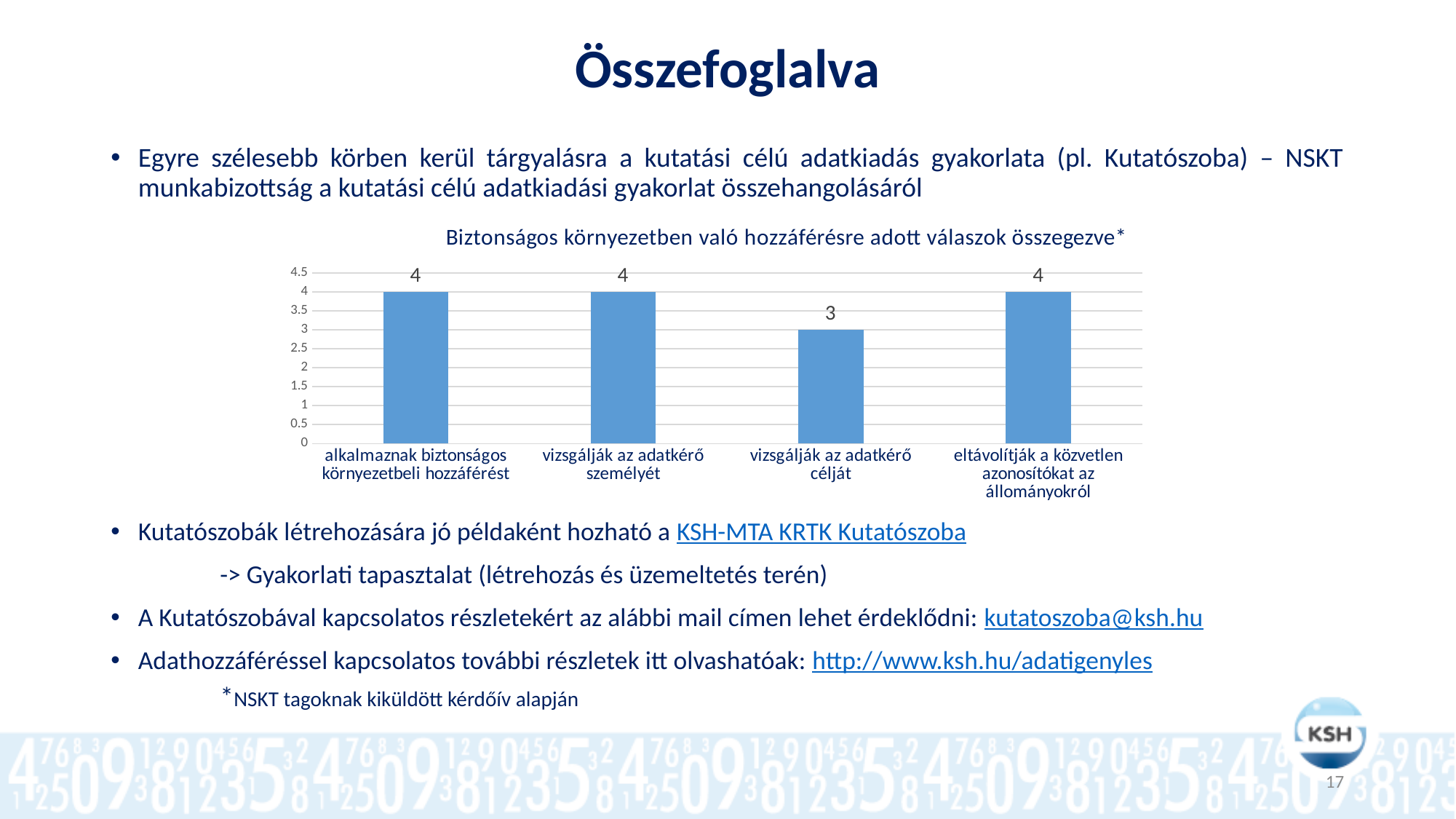
Is the value for "vizsgálják az adatkérő célját" greater or less than 3.5? less What is the value for "alkalmaznak biztonságos környezetbeli hozzáférést"? 4 What is the difference between the value for "vizsgálják az adatkérő személyét" and the value for "vizsgálják az adatkérő célját"? 1 What kind of chart is shown on the slide? bar chart What is the value for "vizsgálják az adatkérő célját"? 3 What is the title of the chart? Biztonságos környezetben való hozzáférésre adott válaszok összegezve* Which category has the lowest value? vizsgálják az adatkérő célját What is the value for "eltávolítják a közvetlen azonosítókat az állományokról"? 4 What is the highest value shown on the y axis? 4.5 How many categories have a value of 4? 3 How many categories are shown on the x axis? 4 Which is larger: the value for "alkalmaznak biztonságos környezetbeli hozzáférést" or the value for "vizsgálják az adatkérő célját"? alkalmaznak biztonságos környezetbeli hozzáférést